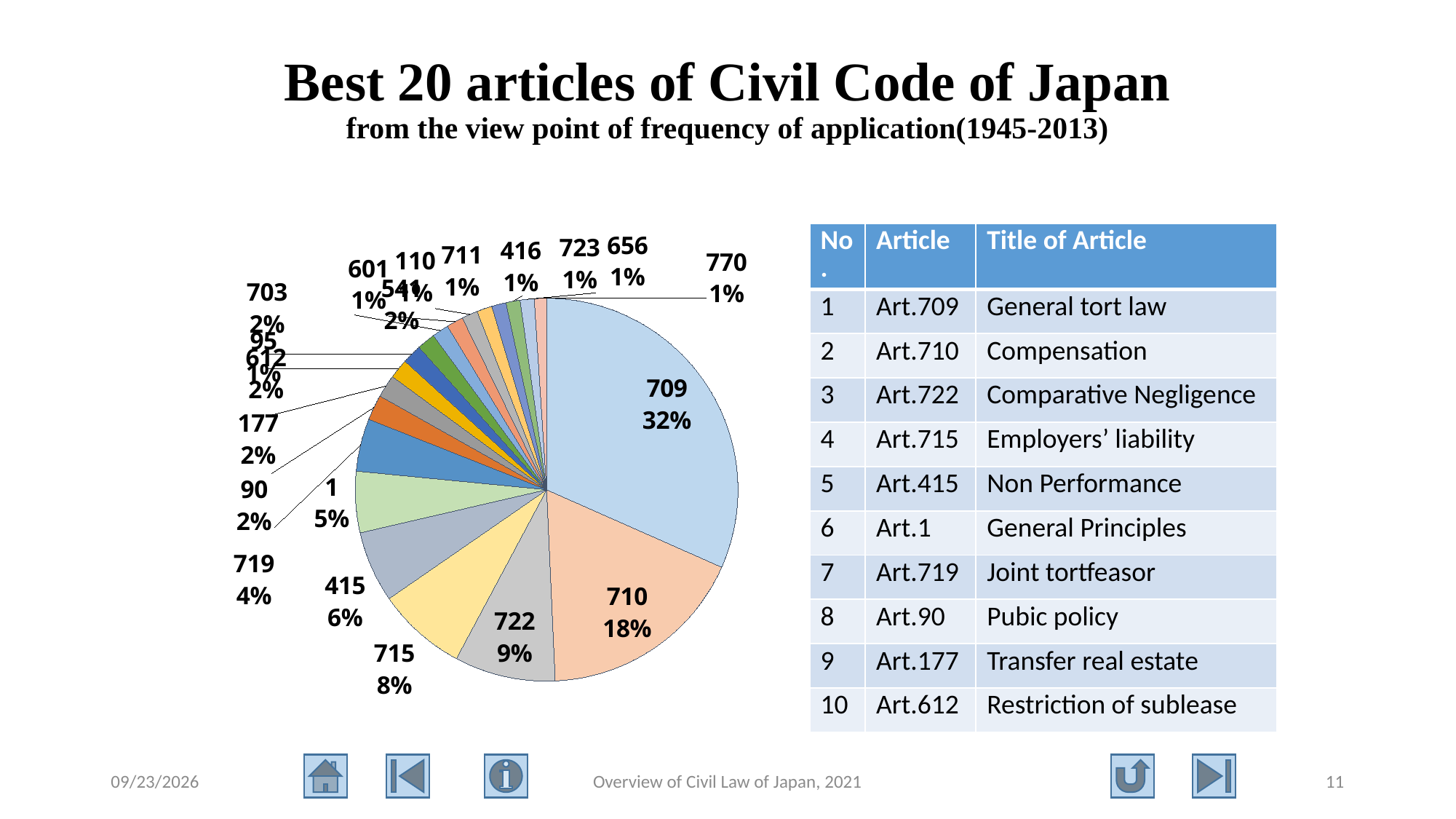
What percentage is shown for article 415? 6% Which slice is larger, article 722 or article 715? 722 What is the difference in percentage points between the slices for article 709 and article 710? 14 percentage points What percentage is shown for article 715? 8% How many slices does the pie chart have? 20 What percentage is shown for article 719? 4% What share of the pie does article 709 account for? 32% What percentage is shown for article 710? 18% What is the main title of the slide? Best 20 articles of Civil Code of Japan What percentage is shown for article 722? 9% What kind of chart is shown on the slide? pie chart Which article has the largest slice of the pie? 709